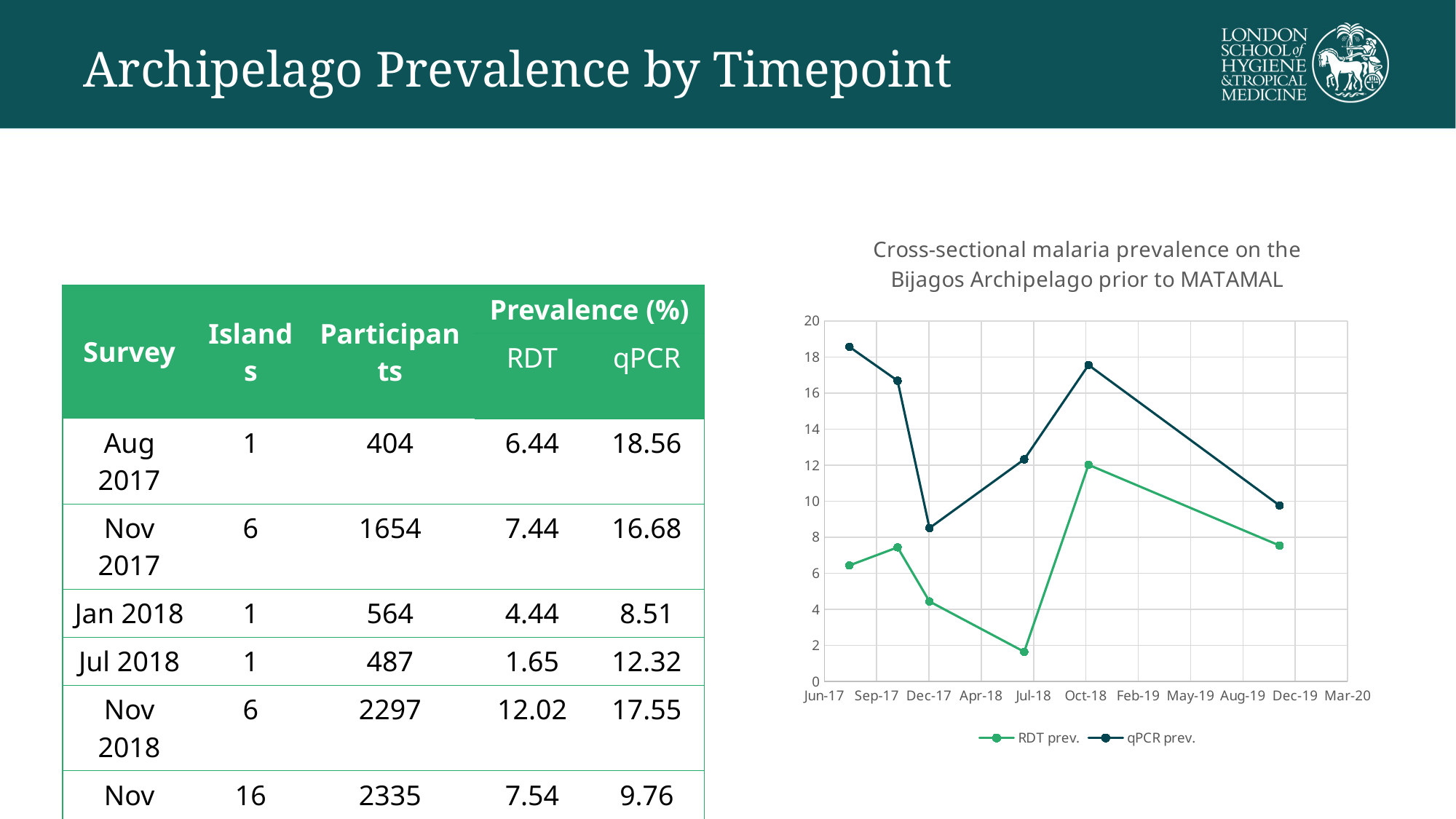
Is the RDT prev. value at Jul-18 greater or less than 4? less At which x-axis timepoint does the RDT prev. series reach its highest value? Nov-18 How many data points are plotted for the qPCR prev. series? 6 How many series does the chart legend list? 2 Which series reaches the highest value on the chart? qPCR prev. At which x-axis timepoint does the RDT prev. series reach its lowest value? Jul-18 Is the qPCR prev. value at Dec-19 greater or less than 8? greater Does the RDT prev. series rise or fall between Jul-18 and Oct-18? rise What is the title of the chart? Cross-sectional malaria prevalence on the Bijagos Archipelago prior to MATAMAL What kind of chart is shown on the slide? line chart At Dec-17, which series has the larger value, RDT prev. or qPCR prev.? qPCR prev. Is the qPCR prev. value at Jul-18 greater or less than 10? greater